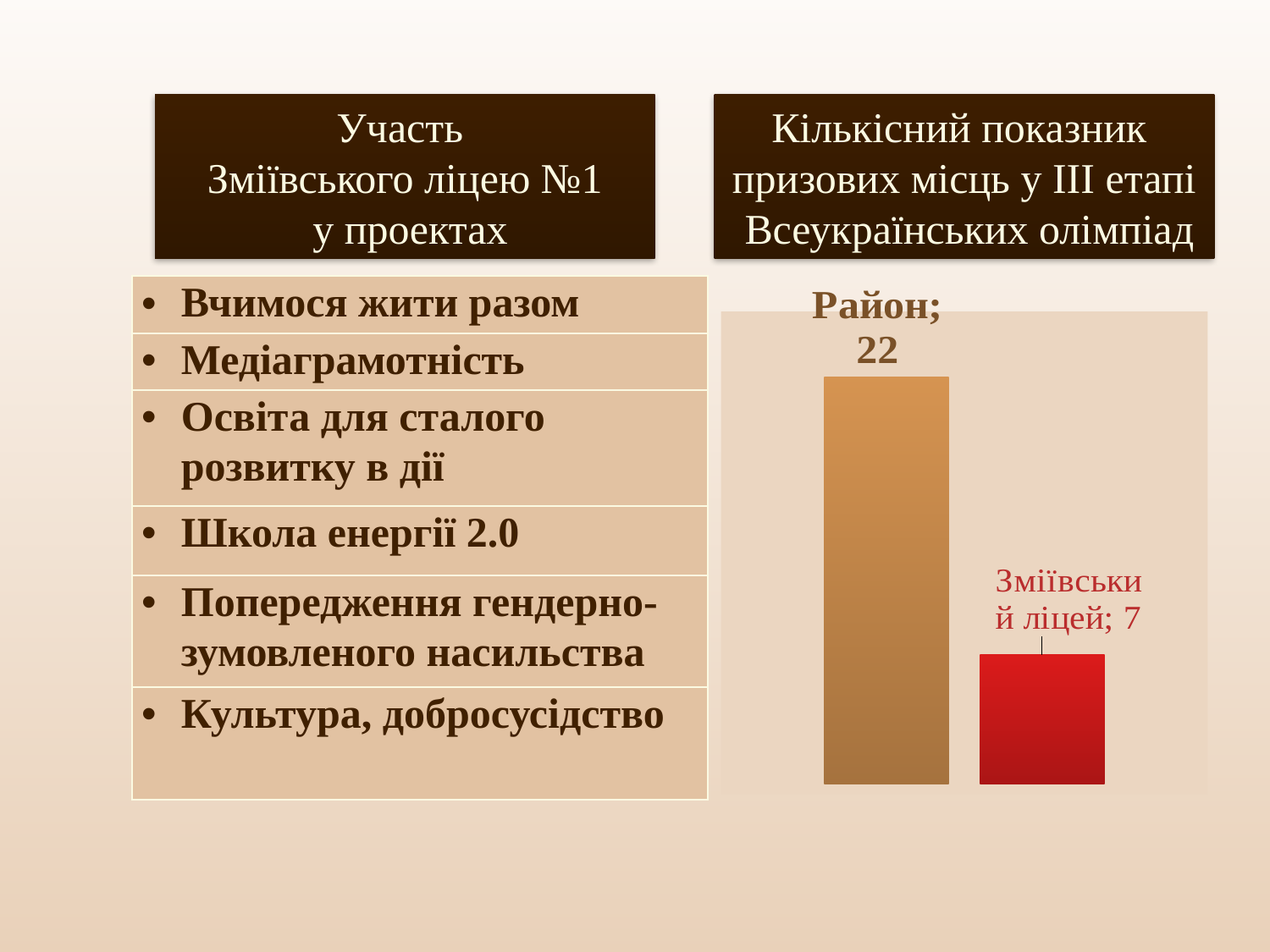
Which category has the highest value in the chart? Район How many bars are plotted in the chart? 2 What is the value for Район in the chart? 22 What is the value for Зміївський ліцей in the chart? 7 Which category has the lowest value in the chart? Зміївський ліцей What is the total of the two values shown in the chart? 29 Which is larger, the value for Район or the value for Зміївський ліцей? Район What kind of chart is shown on the slide? bar chart What colour is the bar for Зміївський ліцей? red What is the difference between the values for Район and Зміївський ліцей? 15 What is the title above the chart? Кількісний показник призових місць у ІІІ етапі Всеукраїнських олімпіад